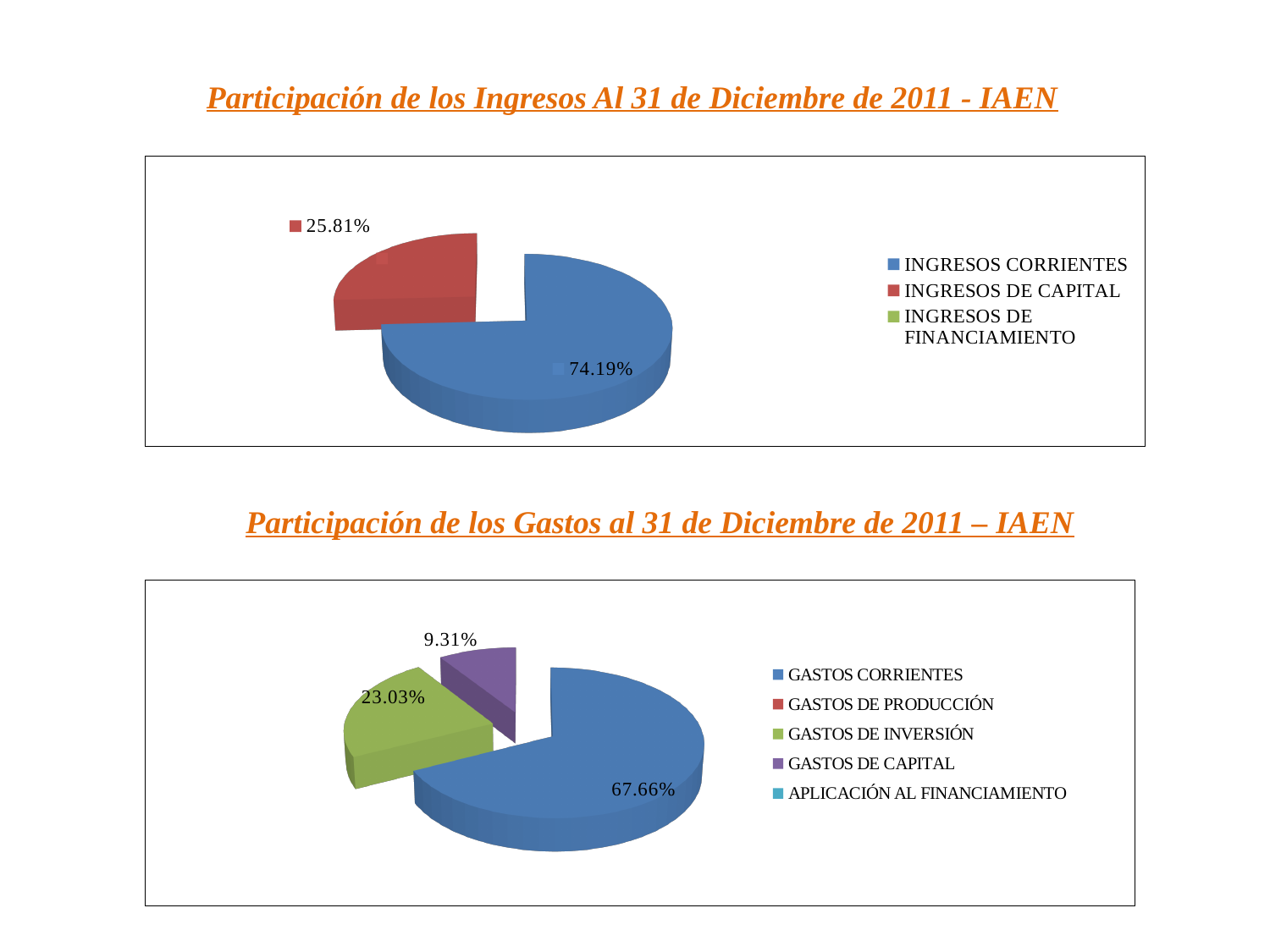
How many entries does the legend of the bottom chart (Participación de los Gastos) list? 5 What type of chart is the top chart (Participación de los Ingresos)? Pie chart In the bottom chart (Participación de los Gastos), which category has the largest slice? GASTOS CORRIENTES How many entries does the legend of the top chart (Participación de los Ingresos) list? 3 In the bottom chart (Participación de los Gastos), which is larger: the GASTOS DE INVERSIÓN slice or the GASTOS DE CAPITAL slice? GASTOS DE INVERSIÓN In the top chart (Participación de los Ingresos), what is the difference in percentage points between the INGRESOS CORRIENTES and INGRESOS DE CAPITAL slices? 48.38 In the top chart (Participación de los Ingresos), which category has the largest slice? INGRESOS CORRIENTES In the top chart (Participación de los Ingresos), what share is labeled for INGRESOS DE CAPITAL? 25.81% In the bottom chart (Participación de los Gastos), what share is labeled for GASTOS DE CAPITAL? 9.31% In the bottom chart (Participación de los Gastos), what share is labeled for GASTOS DE INVERSIÓN? 23.03% In the bottom chart (Participación de los Gastos), what share is labeled for GASTOS CORRIENTES? 67.66% In the top chart (Participación de los Ingresos), what share is labeled for INGRESOS CORRIENTES? 74.19%